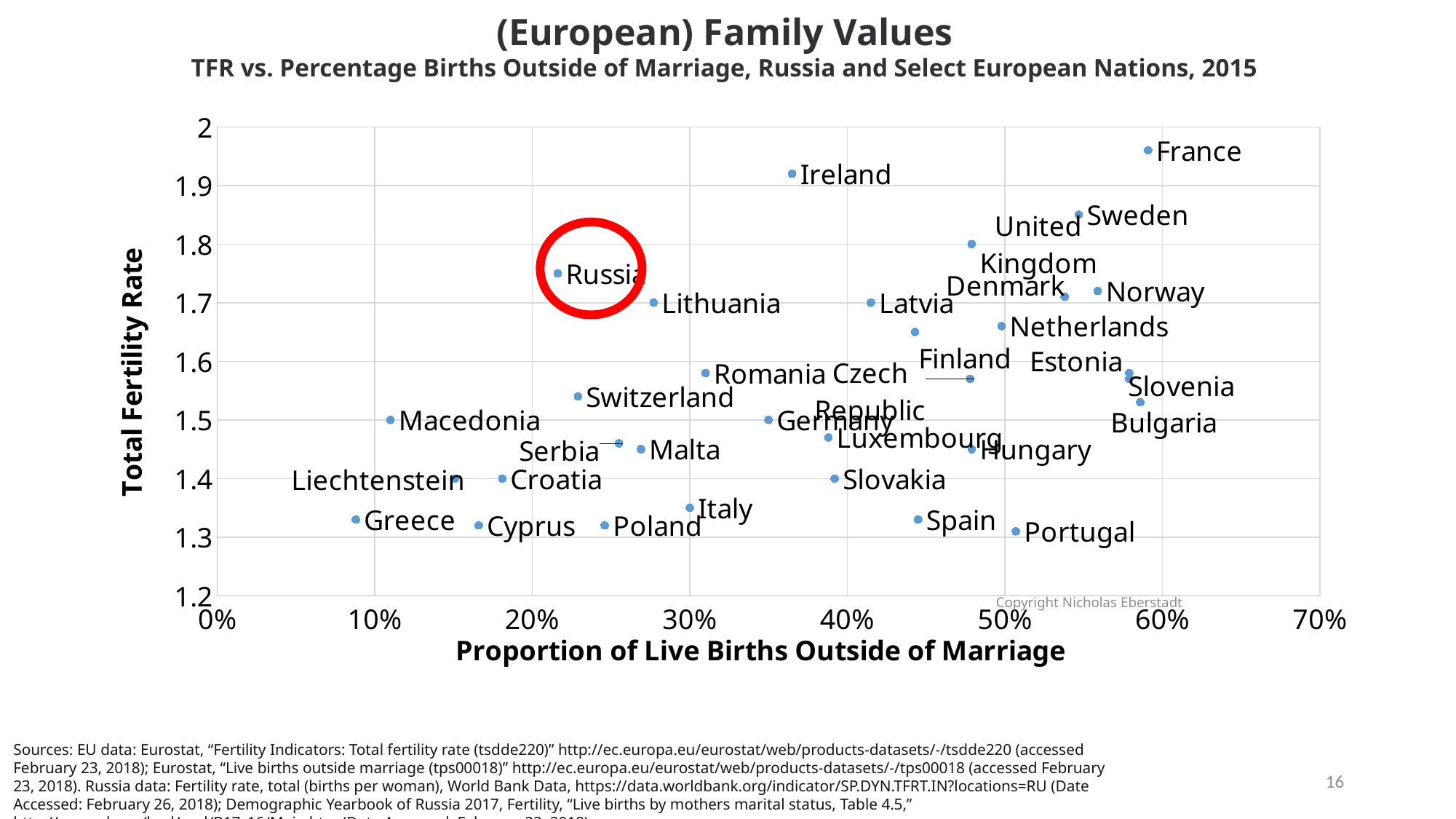
Is the Proportion of Live Births Outside of Marriage for Macedonia greater or less than 20%? less Which has a higher Total Fertility Rate, Ireland or Germany? Ireland Which country is highlighted with a red circle on the chart? Russia Is the Total Fertility Rate for Russia greater or less than 1.7? greater Is the Total Fertility Rate for Portugal greater or less than 1.4? less Which has a higher Proportion of Live Births Outside of Marriage, Sweden or Lithuania? Sweden What kind of chart is shown on the slide? Scatter plot Which country has the highest Total Fertility Rate on the chart? France What is the label of the x axis? Proportion of Live Births Outside of Marriage Which country has the lowest Proportion of Live Births Outside of Marriage on the chart? Greece